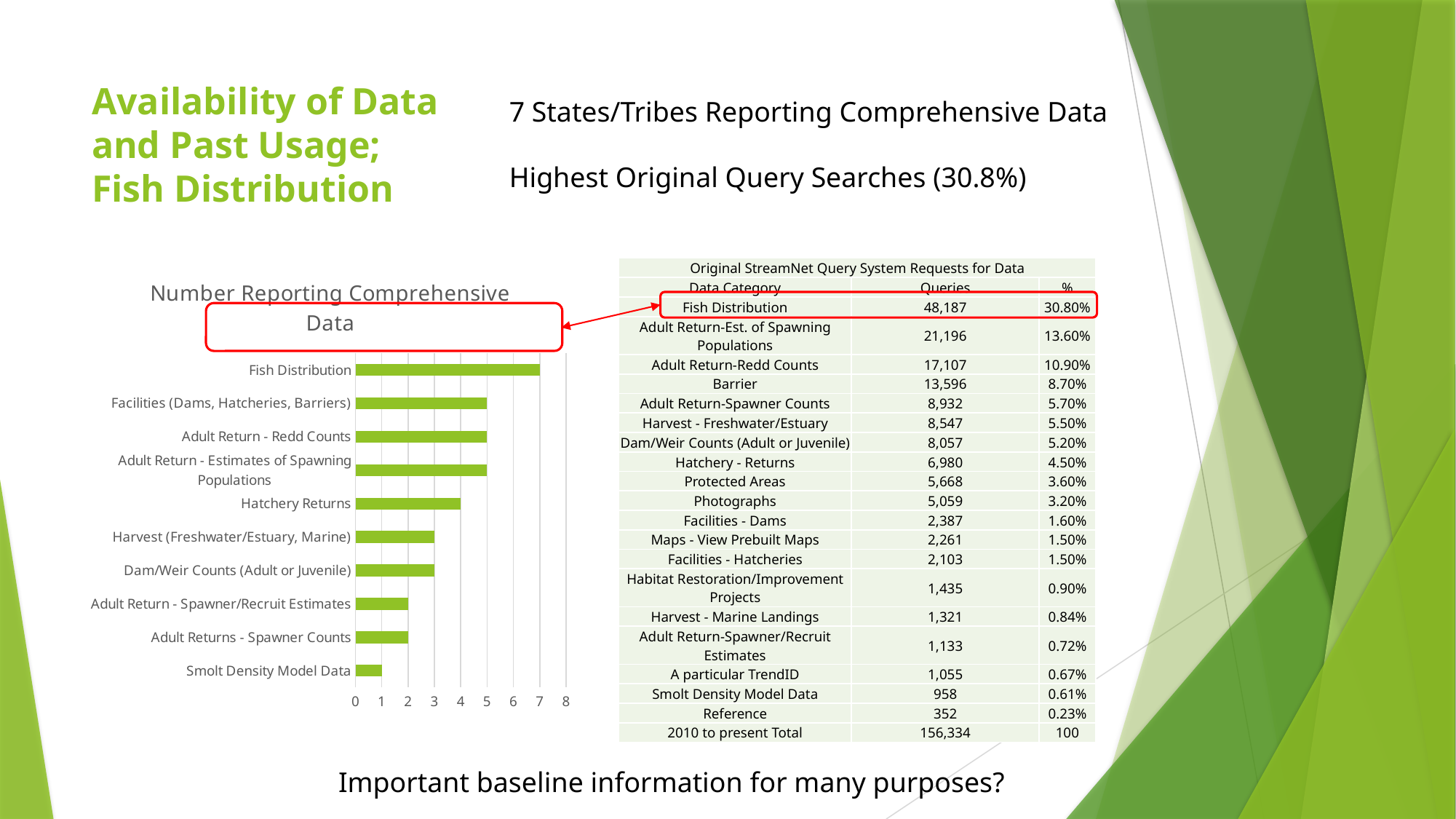
What kind of chart is shown on the left of the slide? Bar chart In the bar chart, is the value for Facilities (Dams, Hatcheries, Barriers) greater or less than 4? greater How many categories are plotted in the bar chart? 10 Which category has the lowest value in the bar chart? Smolt Density Model Data What is the value for Smolt Density Model Data in the bar chart? 1 What is the title of the bar chart? Number Reporting Comprehensive Data In the bar chart, is the value for Dam/Weir Counts (Adult or Juvenile) greater or less than 4? less Which category has the highest value in the bar chart? Fish Distribution What is the value for Hatchery Returns in the bar chart? 4 In the bar chart, which is larger: Hatchery Returns or Harvest (Freshwater/Estuary, Marine)? Hatchery Returns What is the value for Fish Distribution in the bar chart? 7 In the bar chart, what is the difference between the values for Fish Distribution and Smolt Density Model Data? 6